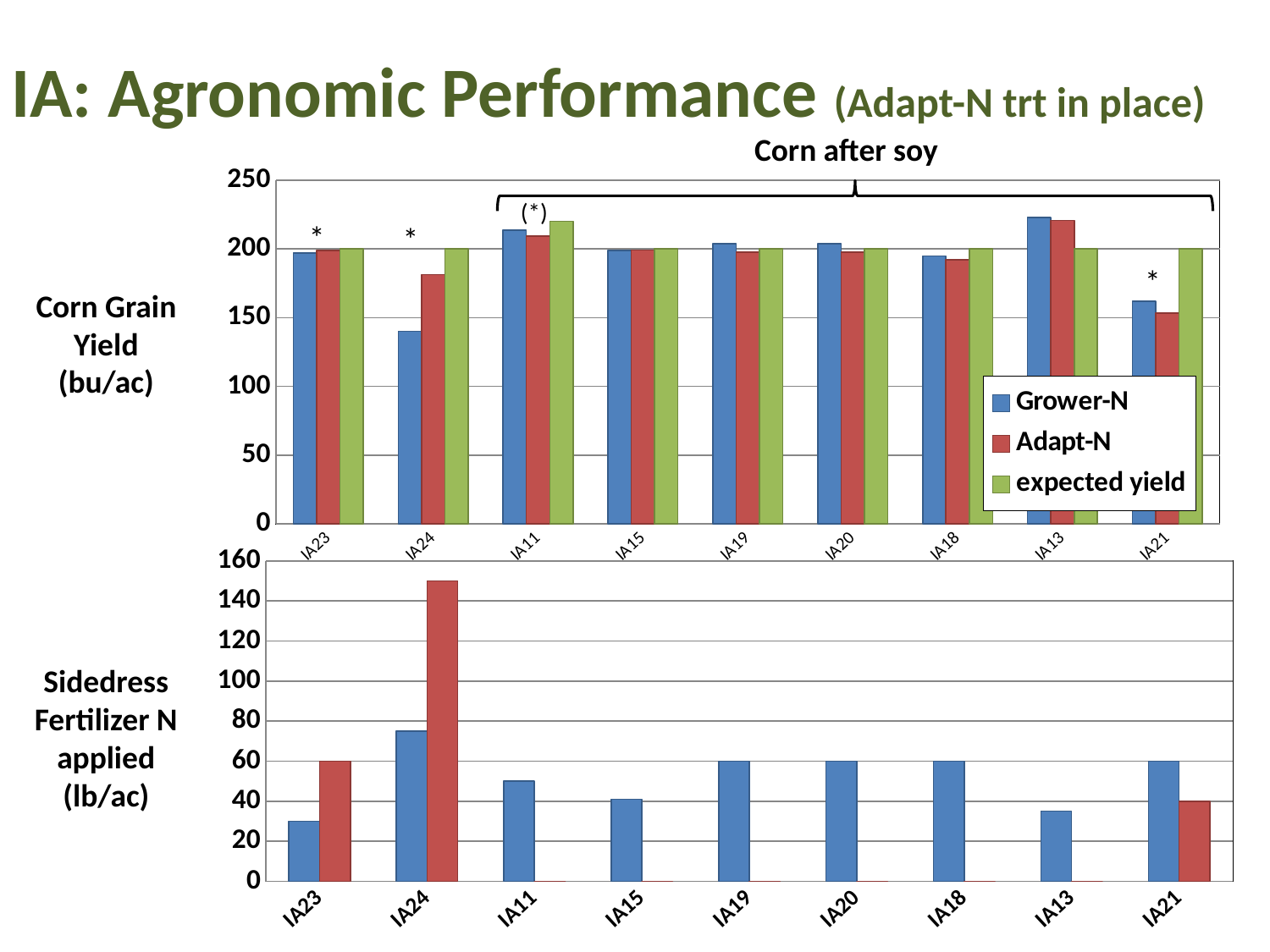
In the top chart (Corn Grain Yield), how many sites are shown on the x axis? 9 In the bottom chart (Sidedress Fertilizer N applied), is the Grower-N value for IA24 greater or less than 60? greater In the bottom chart (Sidedress Fertilizer N applied), what is the Adapt-N value for IA23? 60 In the top chart (Corn Grain Yield), what label is written above the bracket spanning the sites from IA11 to IA21? Corn after soy In the top chart (Corn Grain Yield), is the Grower-N value for IA24 greater or less than 150? less What kind of chart is the bottom chart (Sidedress Fertilizer N applied)? bar chart In the top chart (Corn Grain Yield), which site has the lowest Grower-N yield? IA24 In the top chart (Corn Grain Yield), which is larger for IA24: Grower-N or Adapt-N? Adapt-N In the bottom chart (Sidedress Fertilizer N applied), is the Adapt-N value for IA24 greater or less than 140? greater In the bottom chart (Sidedress Fertilizer N applied), what is the Adapt-N value for IA21? 40 In the bottom chart (Sidedress Fertilizer N applied), which site has the highest Adapt-N value? IA24 In the top chart (Corn Grain Yield), how many series does the legend list? 3